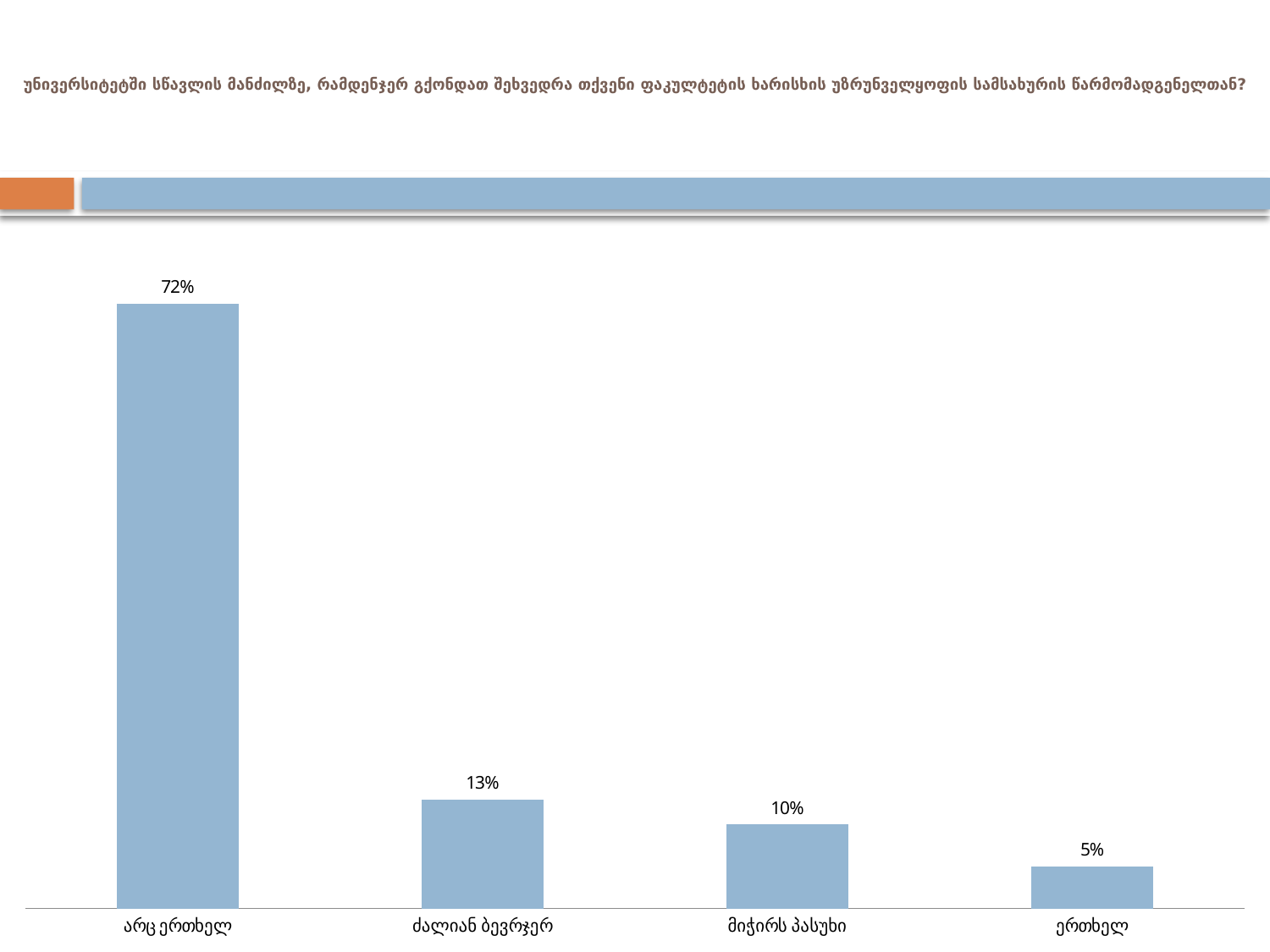
How many categories are shown in the chart? 4 What is the value for "ძალიან ბევრჯერ"? 13% What kind of chart is shown on the slide? bar chart Which category has the highest value? არც ერთხელ What is the difference between the values for "მიჭირს პასუხი" and "ერთხელ"? 5% What is the difference between the values for "არც ერთხელ" and "ძალიან ბევრჯერ"? 59% What colour are the bars in the chart? light blue What is the value for "არც ერთხელ"? 72% What is the value for "მიჭირს პასუხი"? 10% What is the value for "ერთხელ"? 5% Which category has the lowest value? ერთხელ Which is larger, the value for "ძალიან ბევრჯერ" or the value for "მიჭირს პასუხი"? ძალიან ბევრჯერ